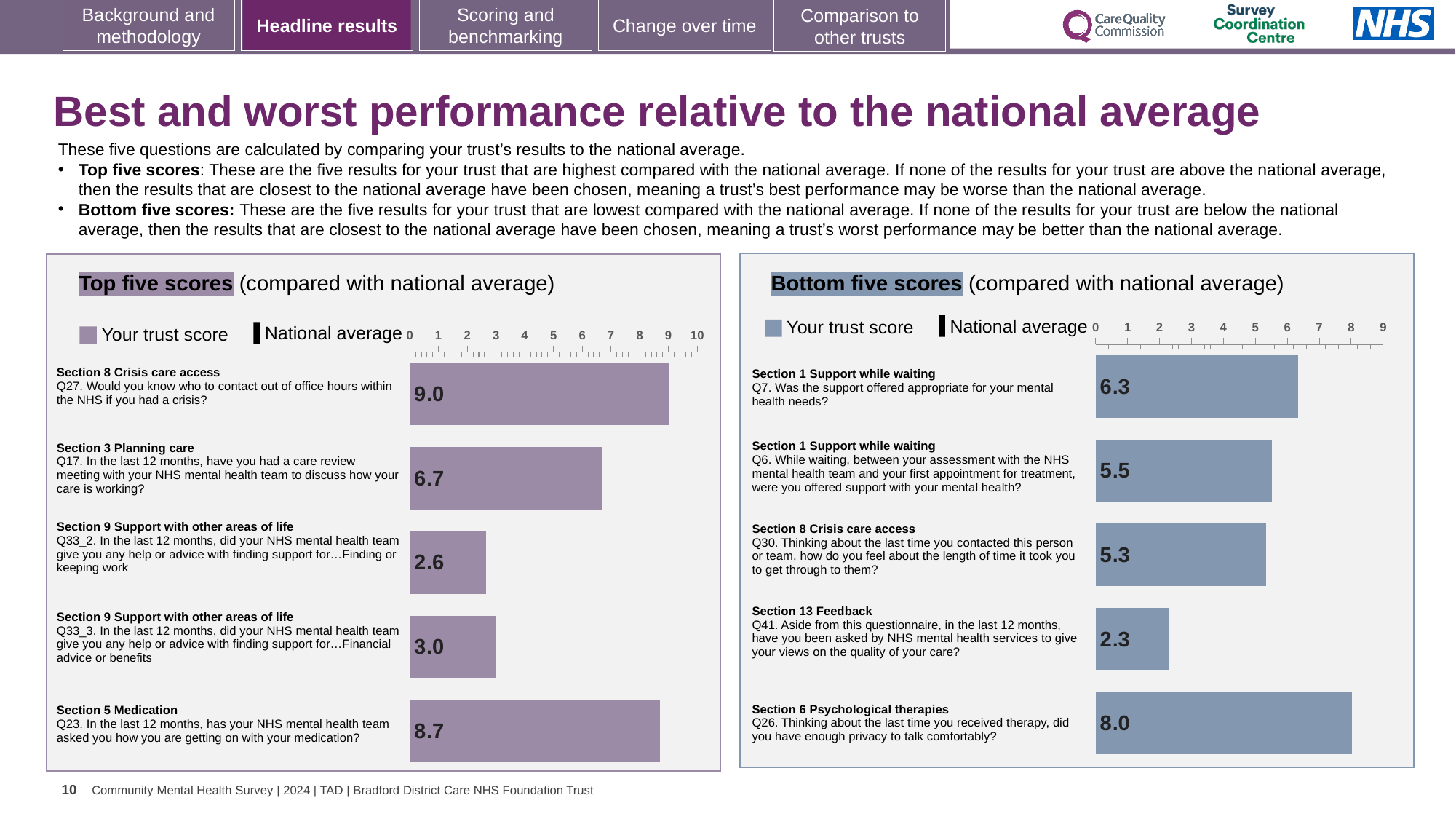
In the Bottom five scores chart, which question has the lowest trust score? Q41 How many questions are plotted in the Bottom five scores chart? 5 In the Top five scores chart, what is the trust score for Q17 (Section 3 Planning care)? 6.7 How many entries does the legend of the Bottom five scores chart list? 2 In the Top five scores chart, what is the trust score for Q27 (Section 8 Crisis care access)? 9.0 In the Top five scores chart, which question has the highest trust score? Q27 What type of chart is the Top five scores chart? Bar chart In the Top five scores chart, which question has the lowest trust score? Q33_2 In the Top five scores chart, which has the larger trust score, Q33_3 or Q23? Q23 In the Bottom five scores chart, what is the trust score for Q41 (Section 13 Feedback)? 2.3 In the Bottom five scores chart, what is the trust score for Q26 (Section 6 Psychological therapies)? 8.0 In the Bottom five scores chart, what is the difference between the trust scores for Q7 and Q6? 0.8